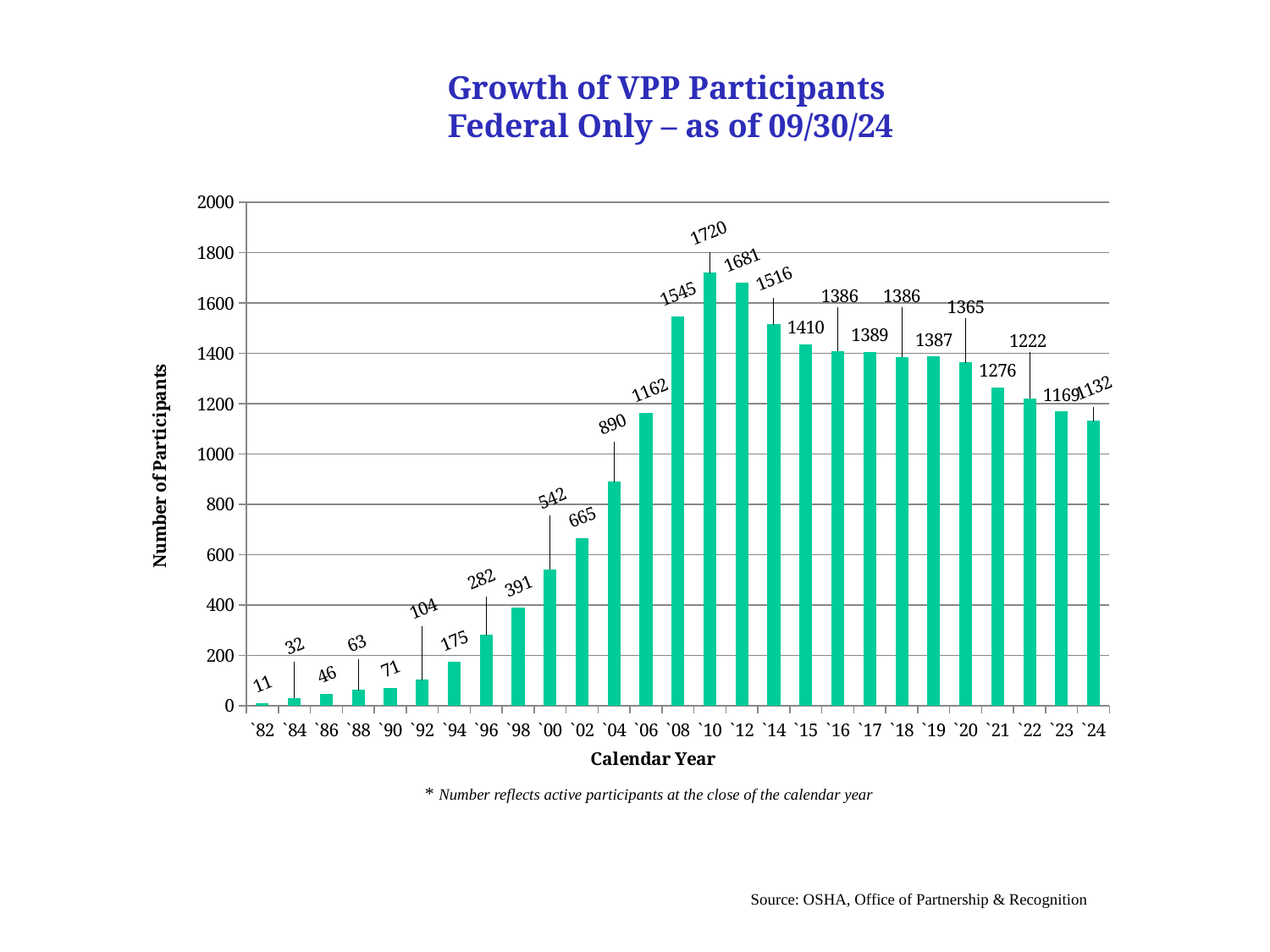
Which year has more participants, `14 or `21? `14 Which calendar year has the highest number of participants? `10 What is the difference in participants between `08 and `06? 383 What kind of chart is shown on the slide? Bar chart Which calendar year has the lowest number of participants? `82 What is the number of participants for `24? 1132 What is the number of participants for `10? 1720 What is the difference in participants between `10 and `12? 39 What is the number of participants for `04? 890 Do the values rise or fall from `20 to `24? Fall How many calendar years are shown on the x axis? 27 Is the value for `02 greater or less than 600? greater